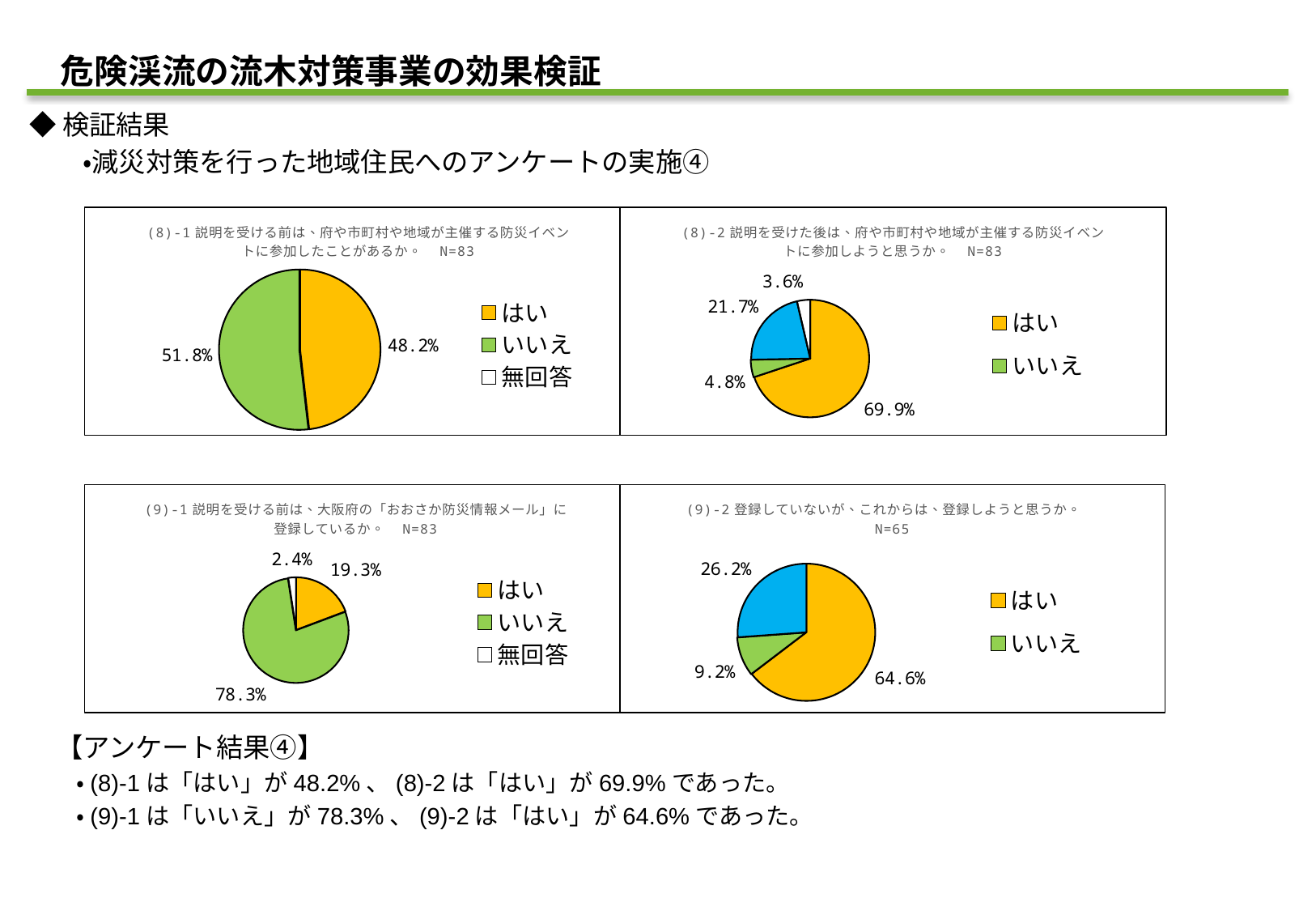
In the bottom-left chart (9)-1, what percentage is 無回答? 2.4% In the top-right chart (8)-2, what percentage answered いいえ? 4.8% In the bottom-right chart (9)-2, what is the difference in percentage points between はい and いいえ? 55.4 In the top-left chart (8)-1, which answer has the larger share, はい or いいえ? いいえ In the top-left chart (8)-1, what percentage answered いいえ? 51.8% In the top-right chart (8)-2, which answer has the largest share? はい In the bottom-left chart (9)-1, how many slices does the pie have? 3 In the top-left chart (8)-1, what percentage answered はい? 48.2% In the top-right chart (8)-2, what percentage answered はい? 69.9% In the top-left chart (8)-1, what is the difference in percentage points between いいえ and はい? 3.6 In the bottom-left chart (9)-1, what percentage answered いいえ? 78.3% What type of chart is used in the bottom-right chart (9)-2? Pie chart